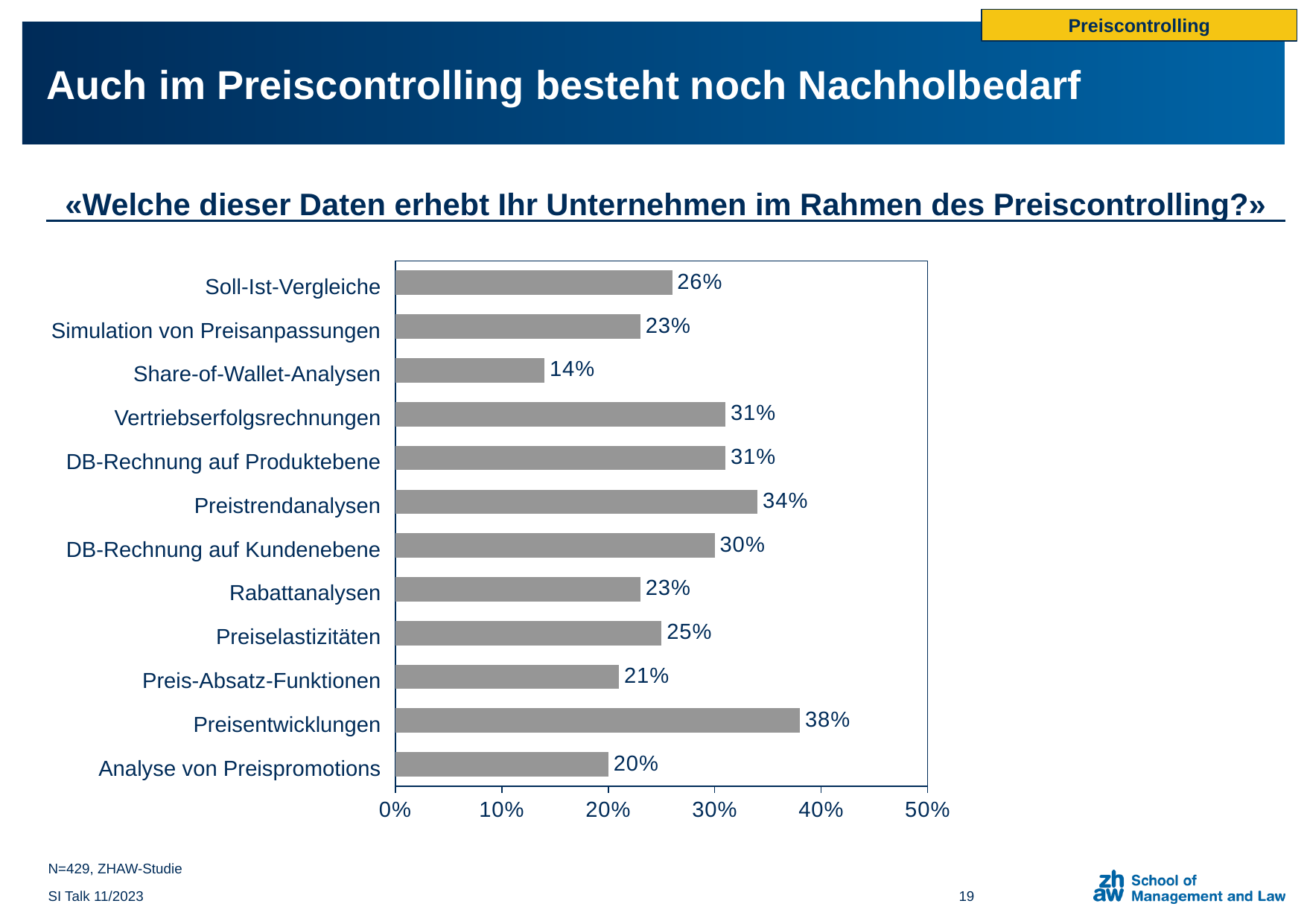
What is the difference between the values for Preisentwicklungen and Analyse von Preispromotions? 18% What kind of chart is shown on the slide? bar chart What is the maximum value shown on the x axis? 50% What is the value for Share-of-Wallet-Analysen? 14% What is the value for Preisentwicklungen? 38% Which is larger, the value for Preistrendanalysen or the value for Soll-Ist-Vergleiche? Preistrendanalysen Which category has the lowest value? Share-of-Wallet-Analysen What is the difference between the values for Vertriebserfolgsrechnungen and Rabattanalysen? 8% How many categories are shown in the chart? 12 Is the value for Preis-Absatz-Funktionen greater or less than 30%? less Which category has the highest value? Preisentwicklungen What is the value for DB-Rechnung auf Kundenebene? 30%